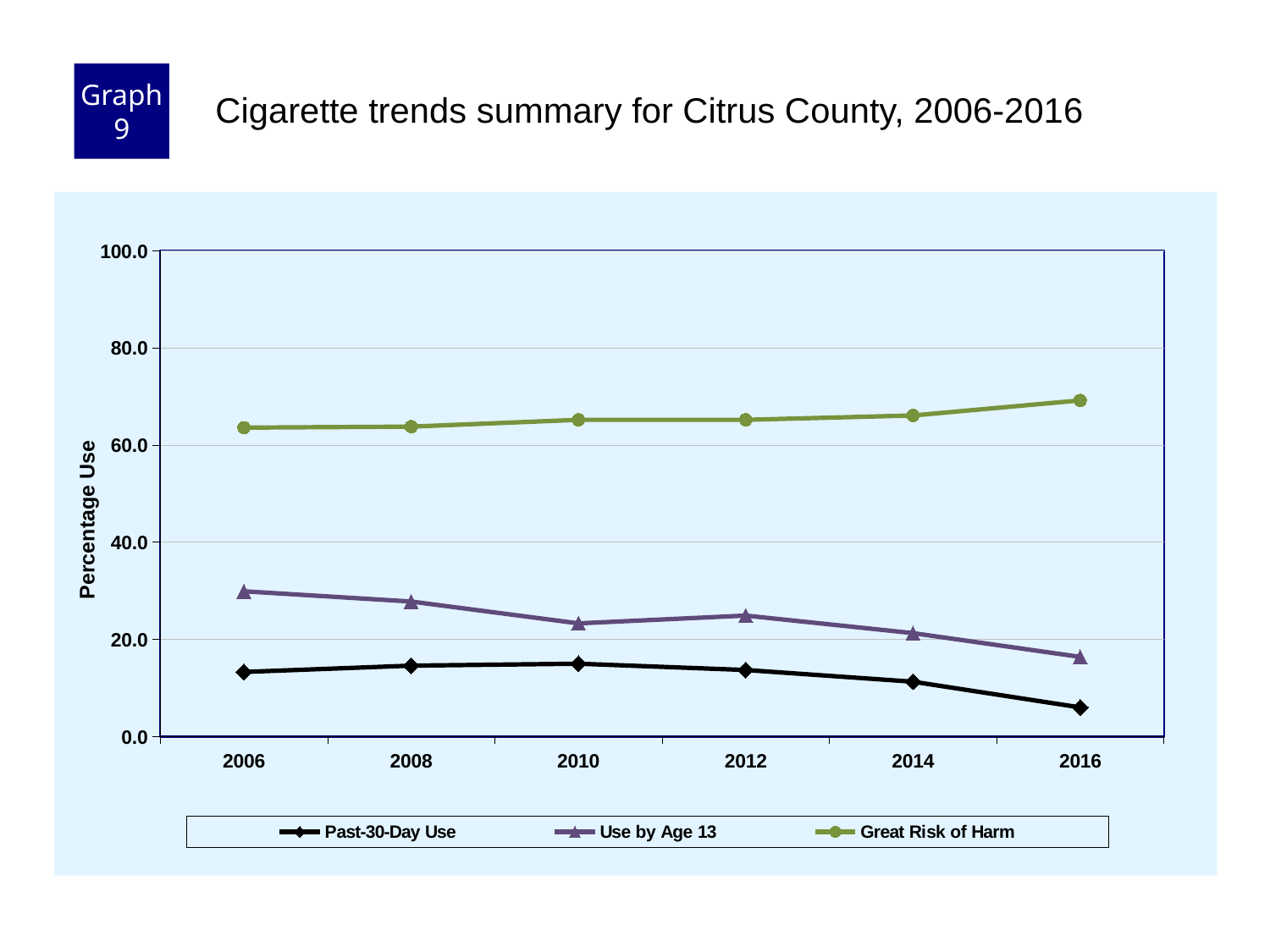
What kind of chart is shown on the slide? Line chart Is the value for Use by Age 13 in 2006 greater or less than 20.0? greater Which series has the lowest values across all years? Past-30-Day Use How many series does the legend list? 3 In which year is Use by Age 13 at its lowest? 2016 Which series has the highest values across all years? Great Risk of Harm How many years are plotted along the x axis? 6 Is the value for Past-30-Day Use in 2016 greater or less than 20.0? less In which year is Great Risk of Harm at its highest? 2016 Does Use by Age 13 rise or fall overall from 2006 to 2016? Fall What is the label on the y axis? Percentage Use Is the value for Great Risk of Harm in 2006 greater or less than 60.0? greater